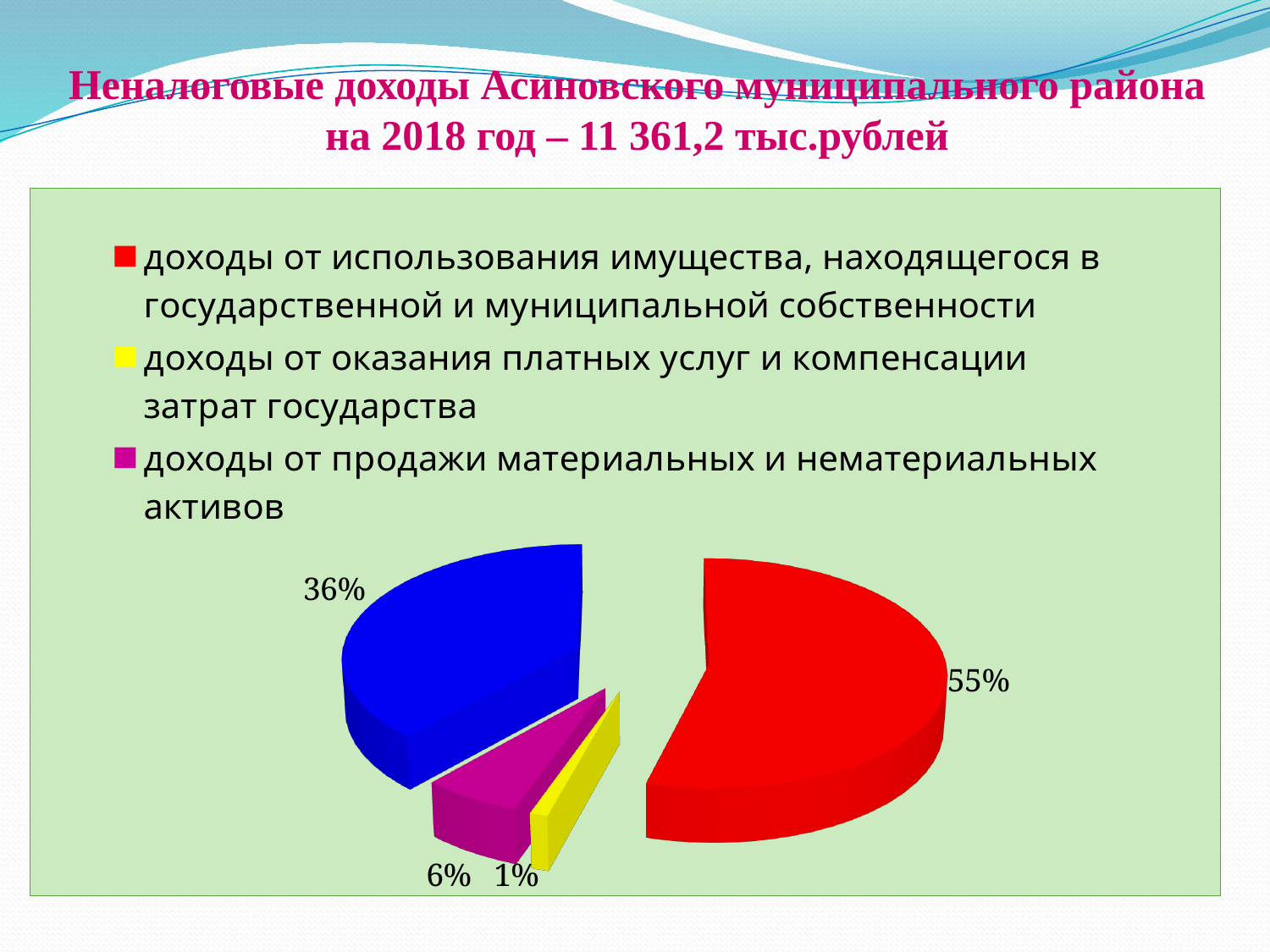
What total amount of non-tax revenue for 2018 is stated in the slide title? 11 361,2 тыс.рублей How many entries does the legend list? 3 Which is larger: the slice for доходы от продажи материальных и нематериальных активов or the slice for доходы от оказания платных услуг и компенсации затрат государства? доходы от продажи материальных и нематериальных активов What kind of chart is shown on the slide? pie chart How many slices does the pie chart have? 4 What share of the pie is taken by доходы от продажи материальных и нематериальных активов? 6% What share of the pie is taken by доходы от использования имущества, находящегося в государственной и муниципальной собственности? 55% What colour is the slice for доходы от оказания платных услуг и компенсации затрат государства? yellow Which legend category has the largest slice of the pie? доходы от использования имущества, находящегося в государственной и муниципальной собственности What share of the pie is taken by доходы от оказания платных услуг и компенсации затрат государства? 1% What is the difference in percentage points between the 55% slice and the 6% slice? 49 percentage points Which legend category has the smallest slice of the pie? доходы от оказания платных услуг и компенсации затрат государства